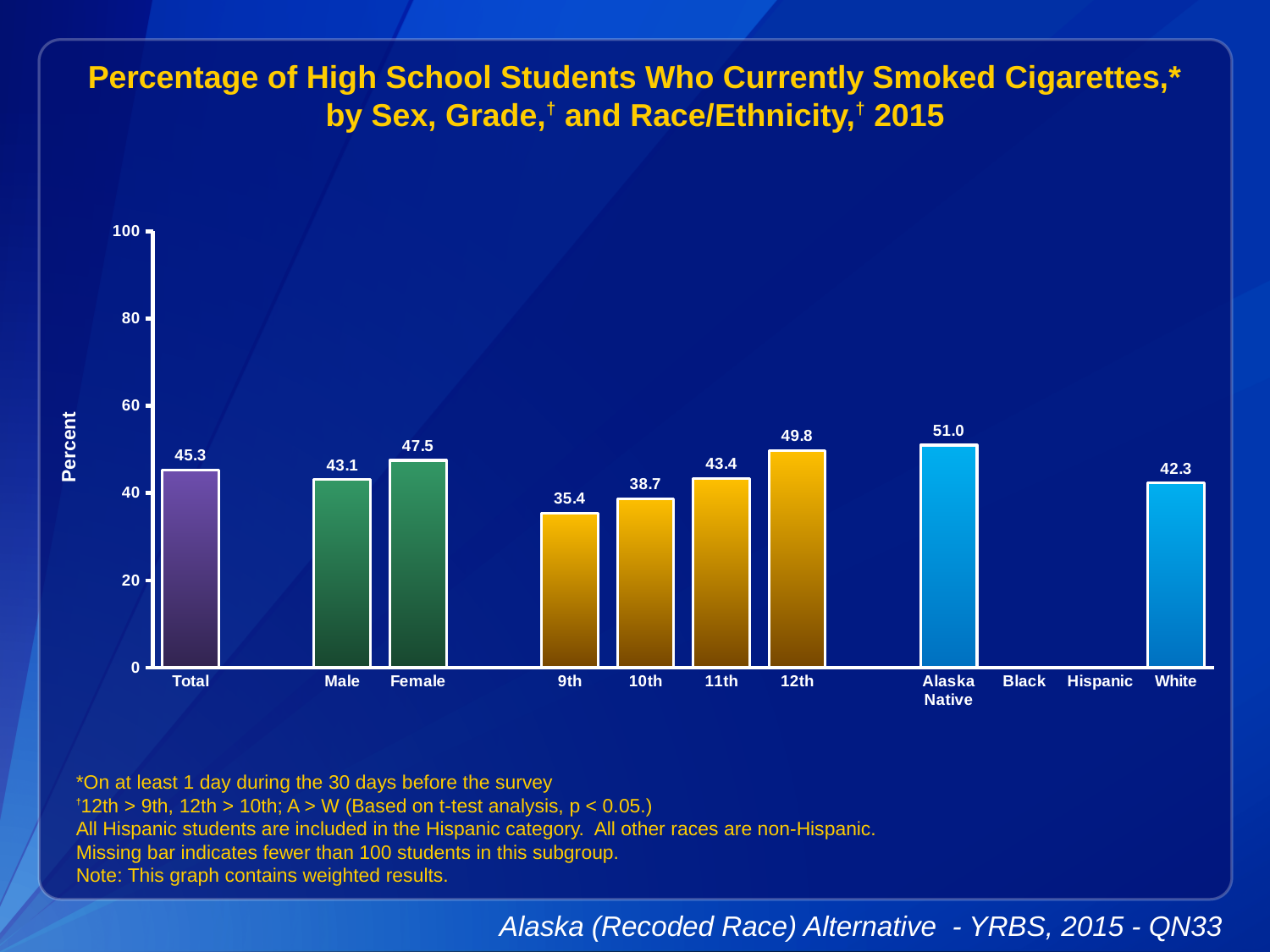
What is the difference between the Female and Male values? 4.4 Do the values rise or fall from 9th grade to 12th grade? rise What is the value for 9th grade? 35.4 How many bars are plotted on the chart? 9 Which is larger, the value for 12th grade or the value for White? 12th What is the value for Female? 47.5 What kind of chart is shown? bar chart What is the value for Alaska Native? 51.0 Is the value for 10th grade greater or less than 40? less Which category has the lowest plotted value? 9th Which category has the highest value? Alaska Native What is the value for Total? 45.3